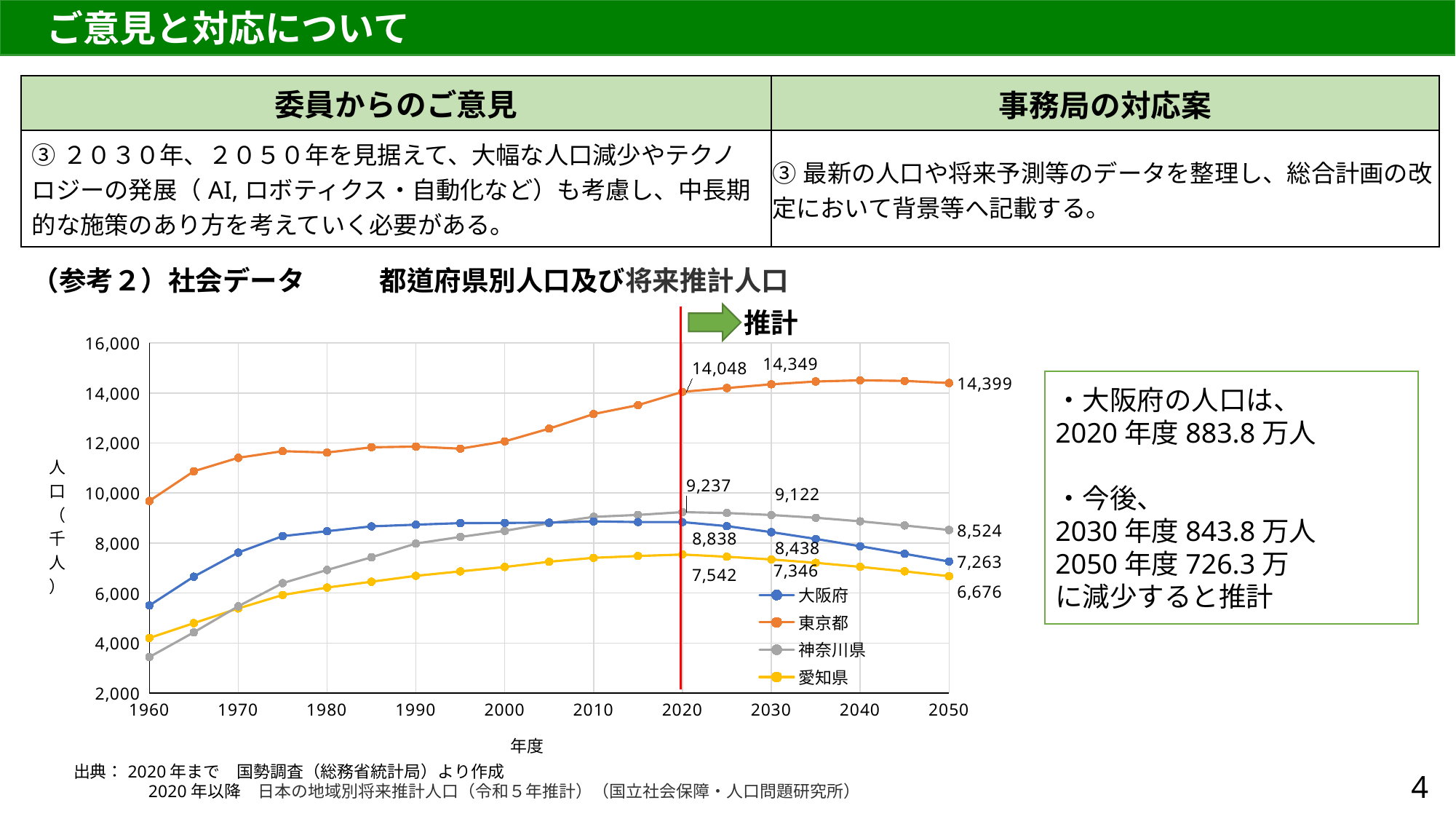
What is the population value labelled for 神奈川県 in 2030? 9,122 What is the population value labelled for 東京都 in 2050? 14,399 Which prefecture has the lowest population in 2020? 愛知県 Which prefecture has the highest population in 2050? 東京都 What is the difference between the 2020 and 2050 values for 大阪府? 1,575 How many series does the chart legend list? 4 What is the population value labelled for 大阪府 in 2020? 8,838 Is the value for 東京都 in 1960 greater or less than 10,000? less What is the population value labelled for 愛知県 in 2050? 6,676 What type of chart is shown on the slide? line chart Does the 大阪府 line rise or fall between 2020 and 2050? fall Which is larger in 2030: the value for 神奈川県 or the value for 大阪府? 神奈川県